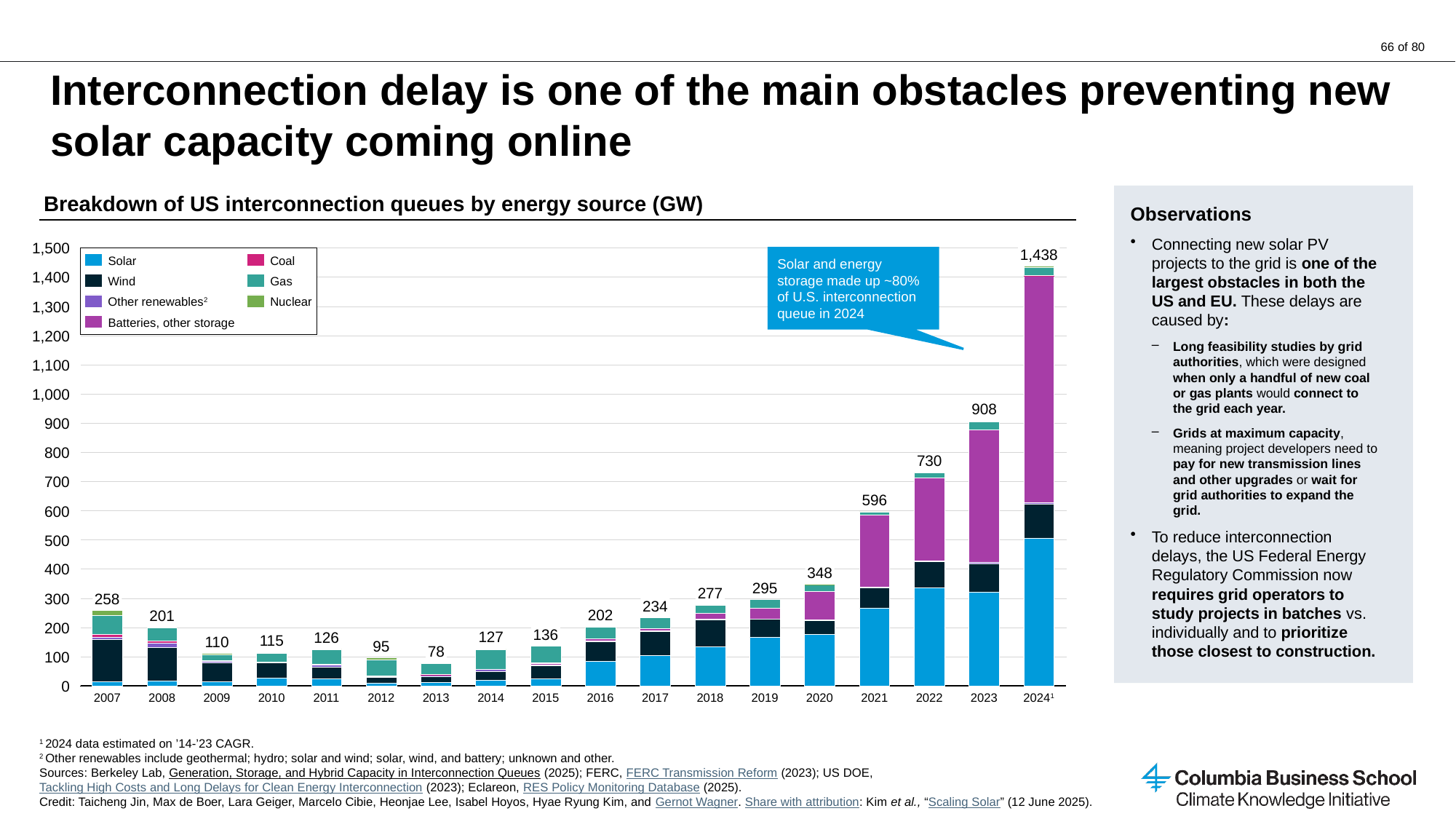
What is the total value shown for 2013? 78 What kind of chart is used to show the breakdown of US interconnection queues? Stacked bar chart What is the difference between the totals for 2024 and 2023? 530 How many years are shown on the x axis of the chart? 18 What is the total value shown for 2024 in the chart? 1,438 Which year has a larger total, 2007 or 2016? 2007 Which year has the lowest total in the chart? 2013 What is the total value shown for 2020? 348 How many energy sources does the chart legend list? 7 Is the Solar value for 2022 greater or less than 400? less Which year has the highest total in the chart? 2024 What is the difference between the totals for 2022 and 2021? 134